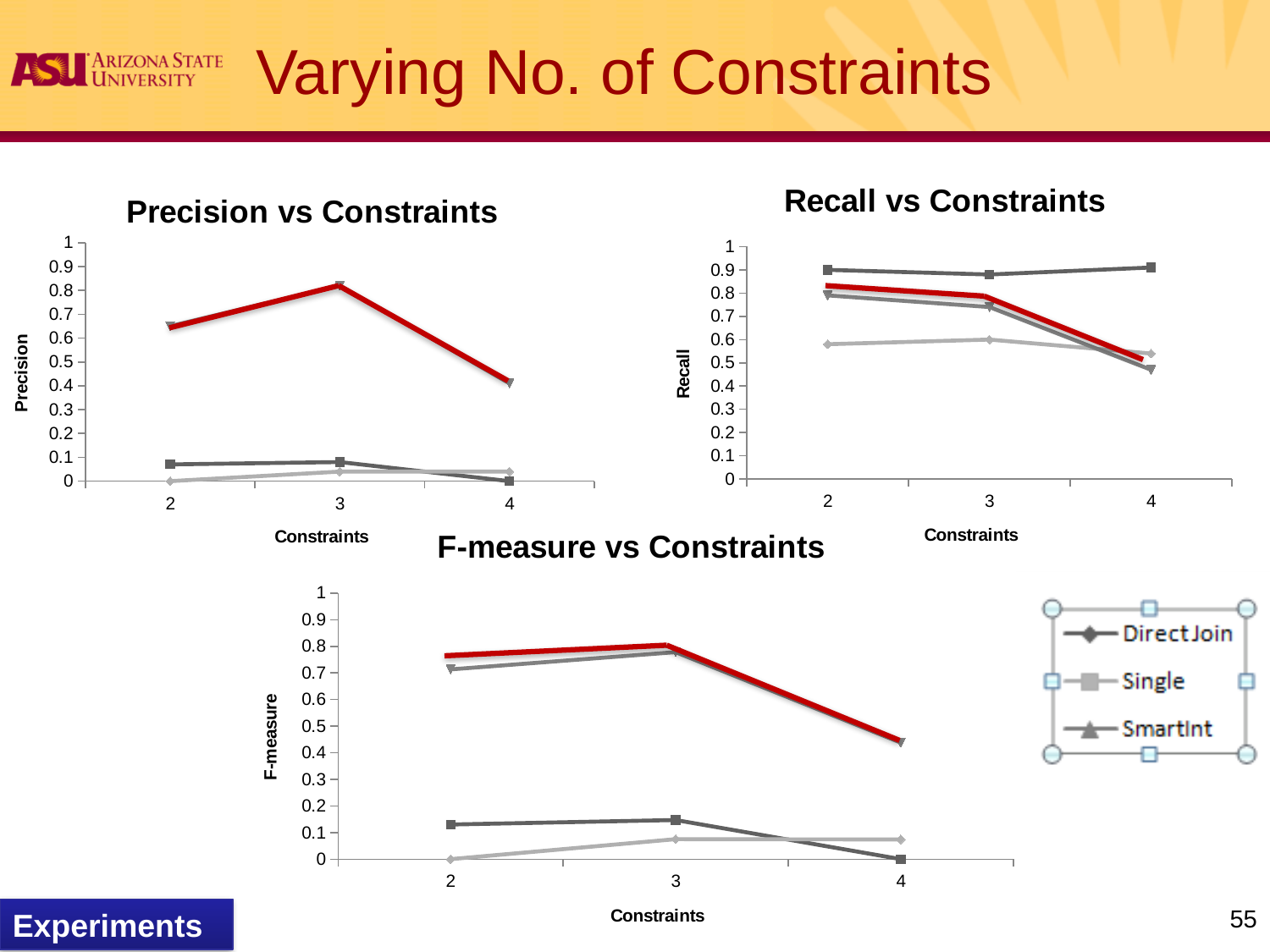
In the Recall vs Constraints chart, which is larger at 4 constraints, Single or DirectJoin? Single How many series does the legend list? 3 What is the x-axis label of the Recall vs Constraints chart? Constraints In the Recall vs Constraints chart, is the value for Single at 4 constraints greater or less than 0.8? greater In the Precision vs Constraints chart, is the value of the red line at 3 constraints greater or less than 0.5? greater In the Recall vs Constraints chart, is the value for DirectJoin at 3 constraints greater or less than 0.7? less How many constraint values are plotted on the x axis of the F-measure vs Constraints chart? 3 What kind of chart is the Precision vs Constraints chart? line chart In the Precision vs Constraints chart, does the red line rise or fall from 3 to 4 constraints? fall What is the y-axis label of the bottom chart? F-measure In the Recall vs Constraints chart, which series has the highest value at 2 constraints? Single